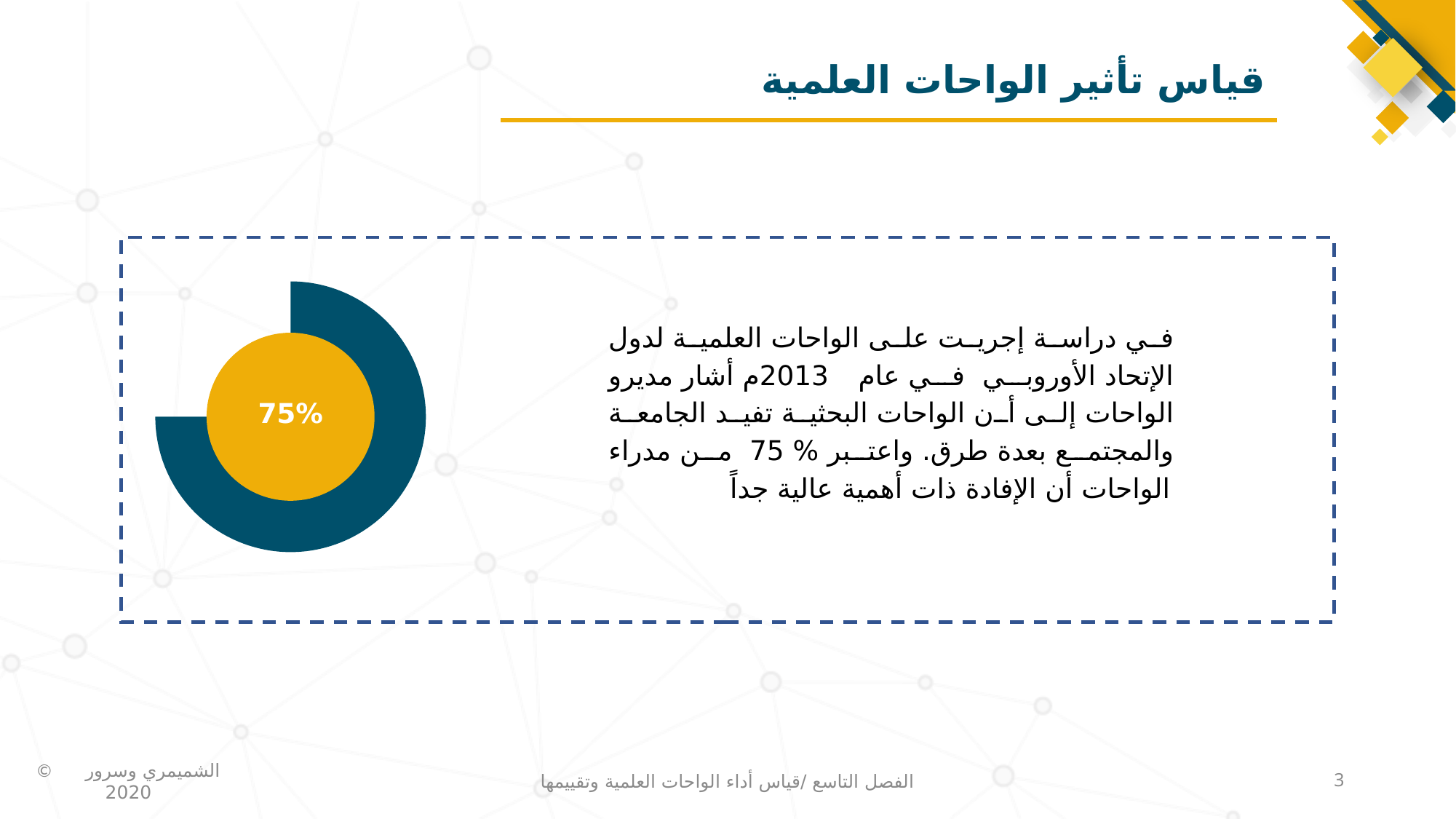
How many data values are labelled on the ring chart? 1 What share of the ring is left unfilled, given the printed value of 75%? 25% Is the filled portion of the ring chart greater or less than 50%? greater What kind of chart is shown on the slide? doughnut chart What colour is the centre circle that holds the 75% label? yellow Which is larger on the ring chart, the filled portion or the unfilled portion? the filled portion What colour is the filled portion of the ring chart? dark teal What value is printed in the centre of the ring chart? 75%